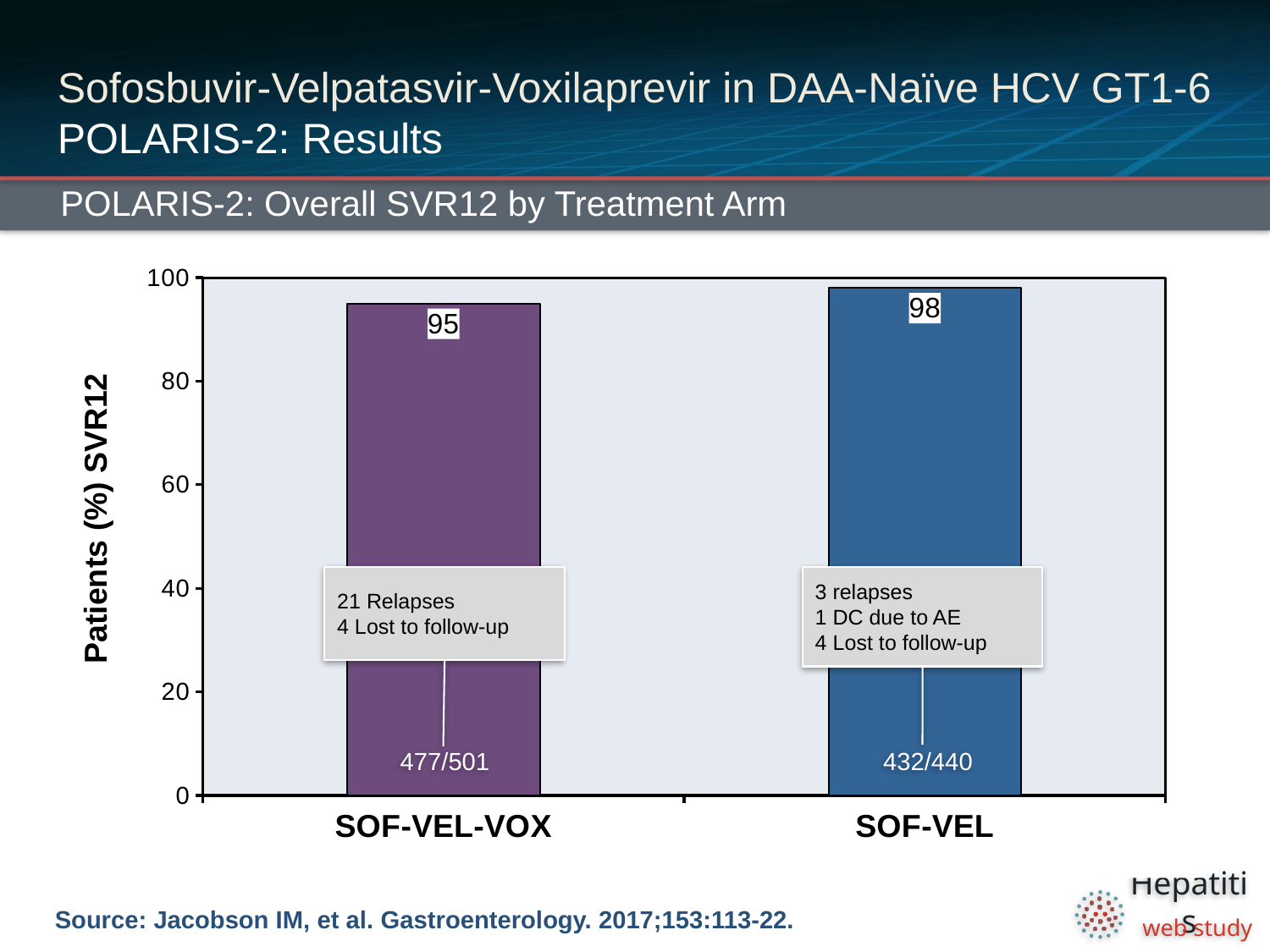
Is the SVR12 value for SOF-VEL-VOX greater or less than 80? greater Which treatment arm has the highest SVR12 rate? SOF-VEL What is the title of the chart? POLARIS-2: Overall SVR12 by Treatment Arm How many treatment arms are shown in the chart? 2 Which is larger, the SVR12 for SOF-VEL-VOX or for SOF-VEL? SOF-VEL What fraction of patients is shown for the SOF-VEL-VOX bar? 477/501 Which treatment arm has the lowest SVR12 rate? SOF-VEL-VOX What kind of chart is shown on the slide? bar chart What is the SVR12 value for SOF-VEL-VOX? 95 What fraction of patients is shown for the SOF-VEL bar? 432/440 What is the difference in SVR12 between SOF-VEL and SOF-VEL-VOX? 3 What is the SVR12 value for SOF-VEL? 98